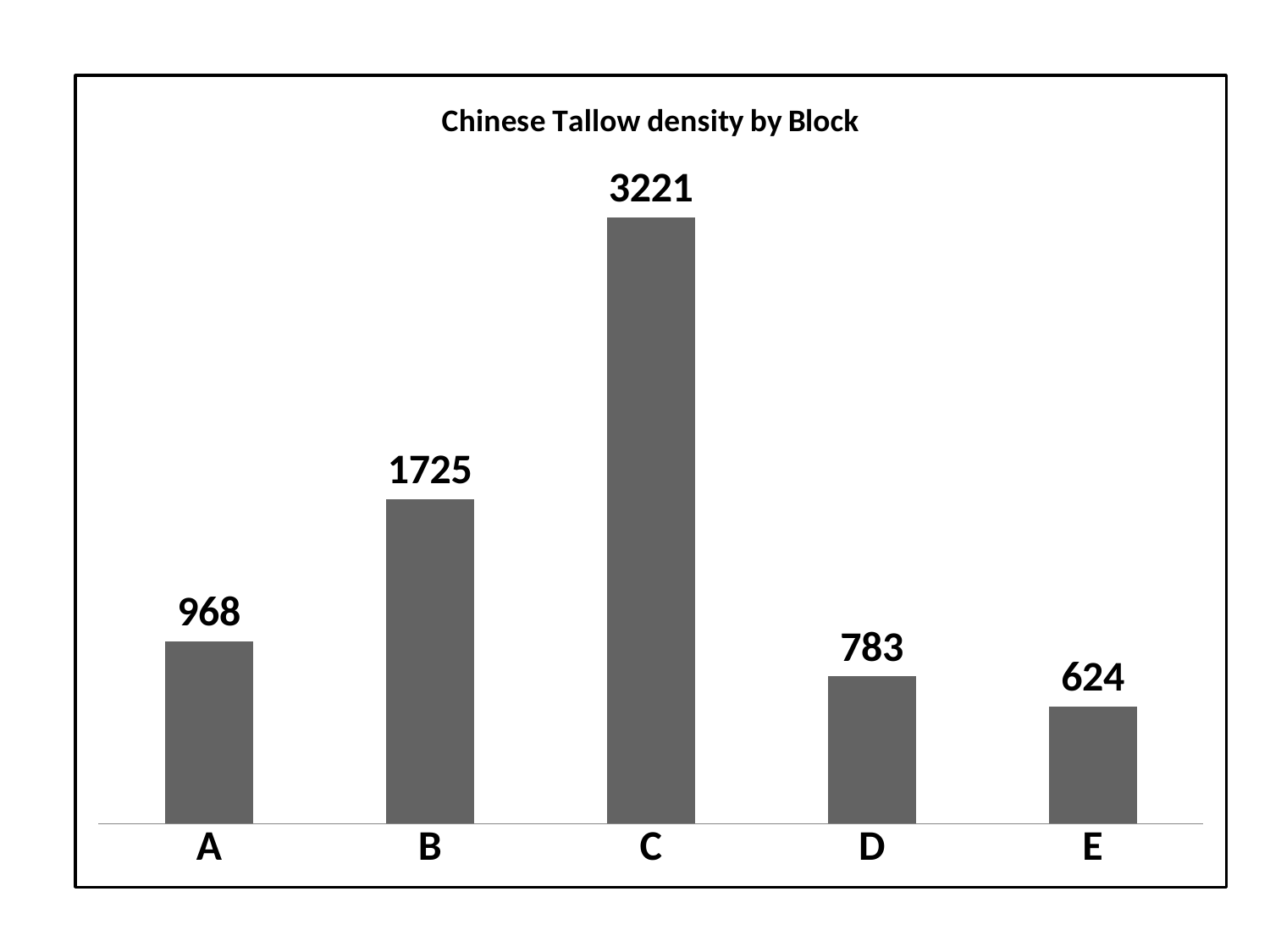
Which block has the highest Chinese Tallow density? C What is the title of the chart? Chinese Tallow density by Block What is the Chinese Tallow density for Block E? 624 Which block has a higher Chinese Tallow density, B or D? B What is the difference in Chinese Tallow density between Block C and Block B? 1496 What is the Chinese Tallow density for Block D? 783 Which block has the lowest Chinese Tallow density? E What is the difference in Chinese Tallow density between Block A and Block D? 185 How many blocks are shown in the chart? 5 What kind of chart is shown on the slide? Bar chart What is the Chinese Tallow density for Block A? 968 What is the Chinese Tallow density for Block C? 3221